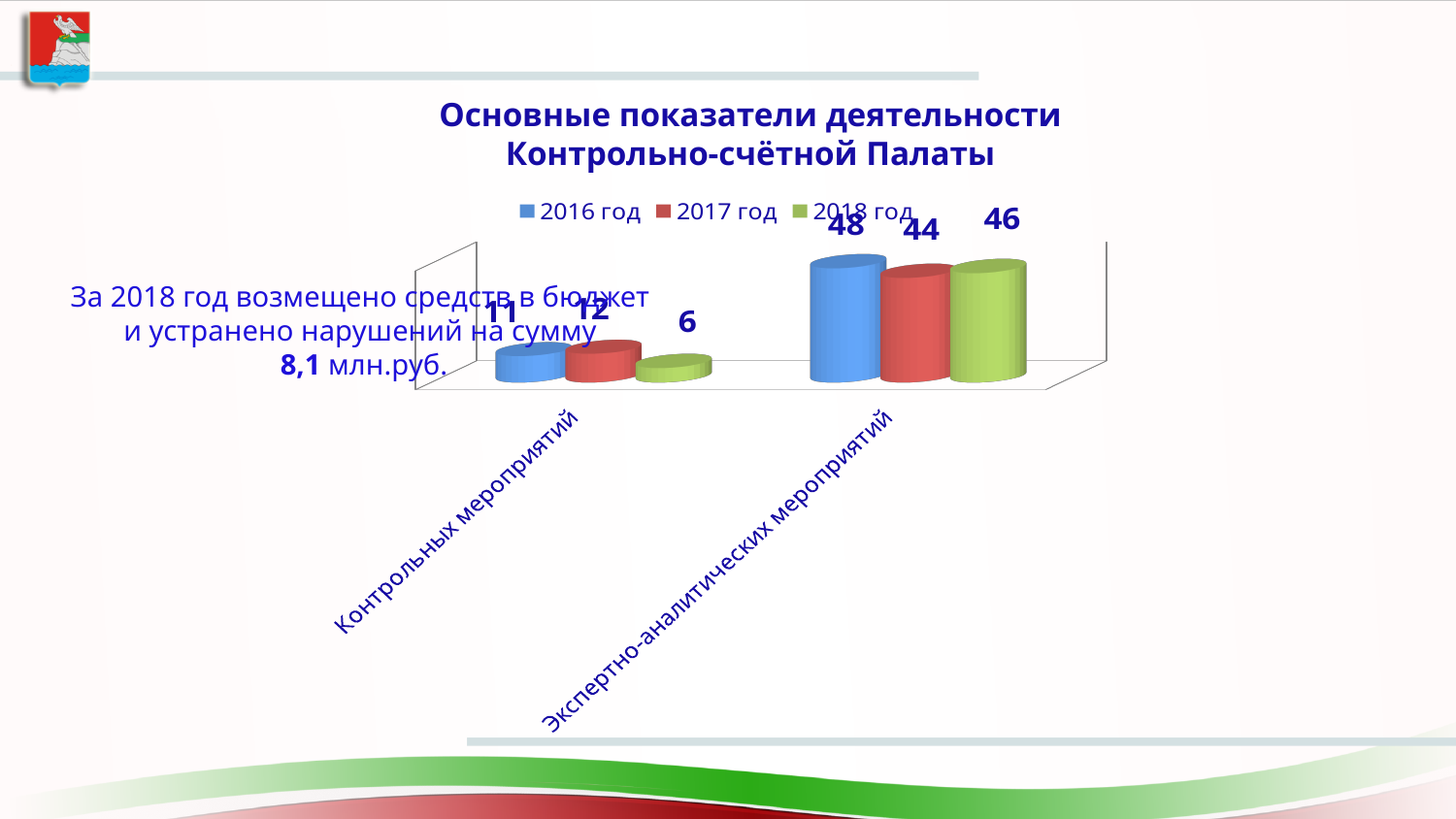
What is the difference between the 2016 год and 2017 год values for Экспертно-аналитических мероприятий? 4 What kind of chart is shown on the slide? Bar chart What is the value for 2016 год for Контрольных мероприятий? 11 How many categories are shown on the x axis of the chart? 2 What is the value for 2018 год for Контрольных мероприятий? 6 How many series does the chart legend list? 3 What is the value for 2017 год for Экспертно-аналитических мероприятий? 44 Which year has the highest value for Экспертно-аналитических мероприятий? 2016 год What is the value for 2016 год for Экспертно-аналитических мероприятий? 48 Which year has the lowest value for Контрольных мероприятий? 2018 год What is the difference between the 2017 год and 2018 год values for Контрольных мероприятий? 6 Which is larger for Экспертно-аналитических мероприятий: the 2018 год value or the 2017 год value? 2018 год